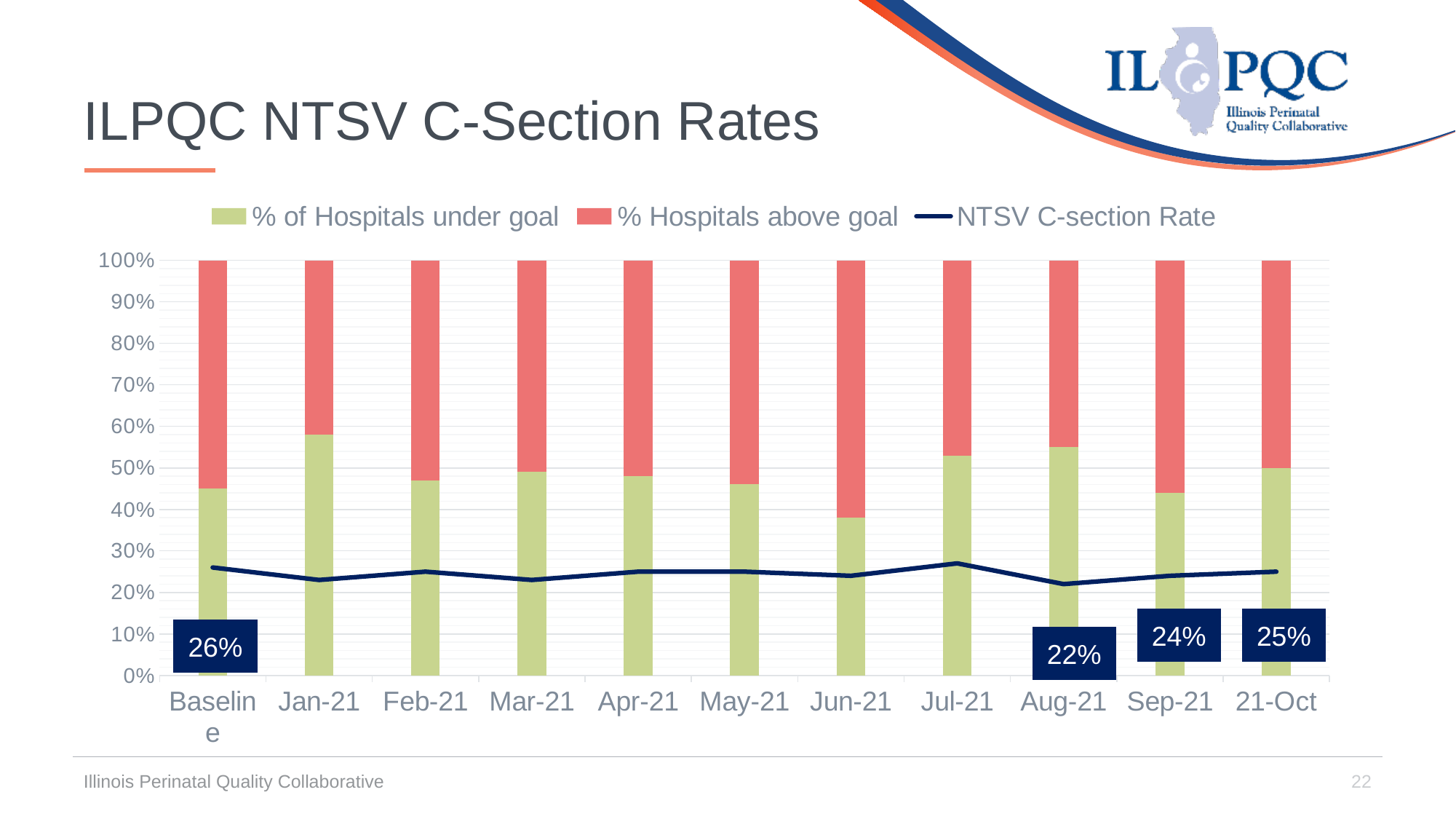
In which month is the % of Hospitals under goal highest? Jan-21 How many time periods are shown on the x axis? 11 How many series does the legend list? 3 Is the % of Hospitals under goal for Jan-21 greater or less than 50%? greater Which has the higher NTSV C-section Rate, Sep-21 or 21-Oct? 21-Oct Is the % of Hospitals under goal for Jun-21 greater or less than 50%? less By how many percentage points did the NTSV C-section Rate fall from Baseline to Aug-21? 4 percentage points In which month is the % of Hospitals under goal lowest? Jun-21 What is the NTSV C-section Rate at Baseline? 26% What is the NTSV C-section Rate for Aug-21? 22% What is the NTSV C-section Rate for Sep-21? 24% What is the NTSV C-section Rate for 21-Oct? 25%